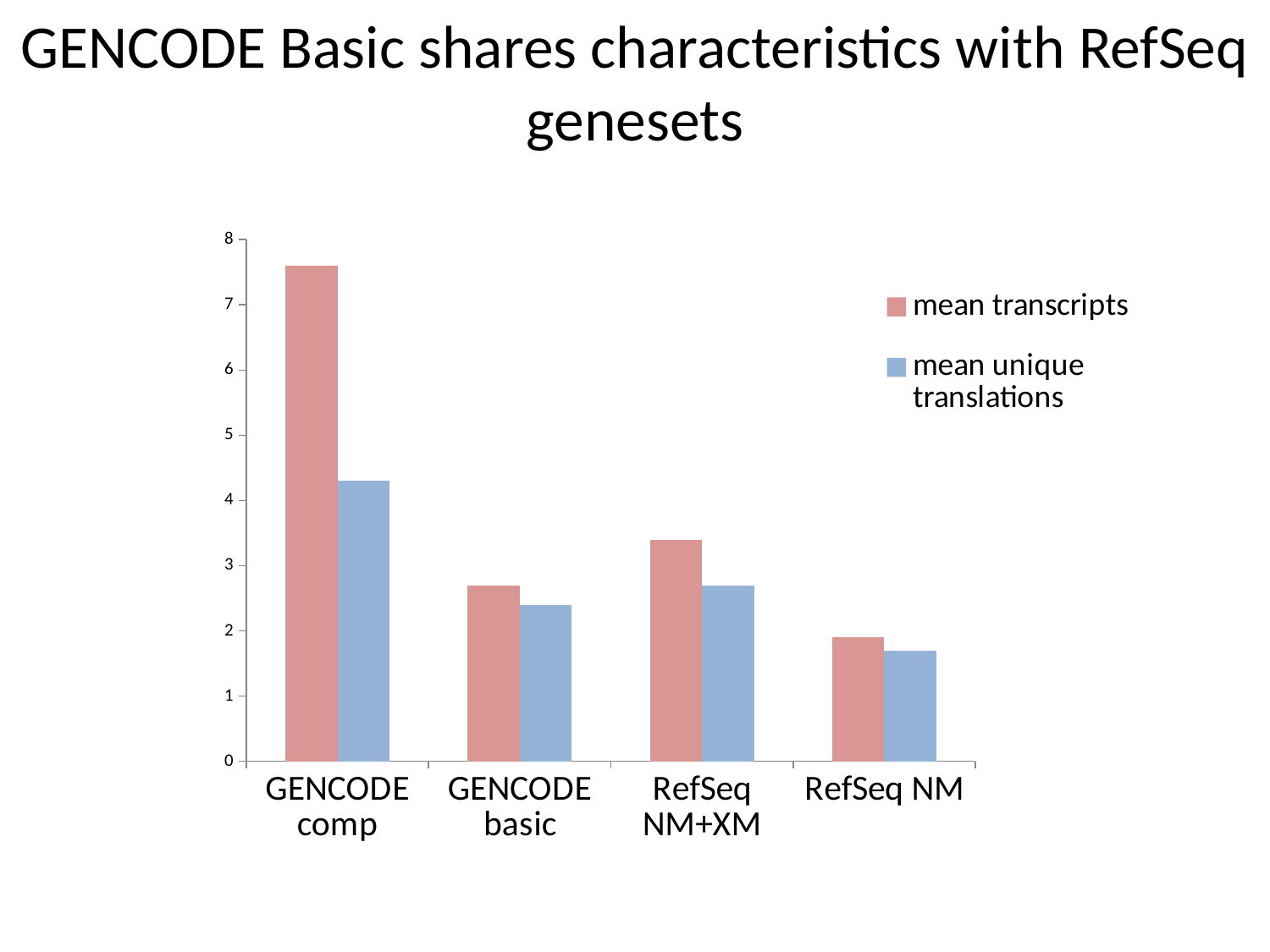
Which category has the highest mean transcripts value? GENCODE comp What kind of chart is shown on the slide? bar chart Which category has the lowest mean unique translations value? RefSeq NM How many series does the chart's legend list? 2 Is the mean transcripts value for GENCODE comp greater or less than 7? greater Which series is shown in blue in the chart's legend? mean unique translations Is the mean transcripts value for RefSeq NM greater or less than 2? less Which is larger: the mean transcripts value for GENCODE basic or for RefSeq NM+XM? RefSeq NM+XM Is the mean unique translations value for GENCODE comp greater or less than 4? greater Which category has the lowest mean transcripts value? RefSeq NM What is the title of the slide containing the chart? GENCODE Basic shares characteristics with RefSeq genesets How many categories are shown on the x axis of the chart? 4